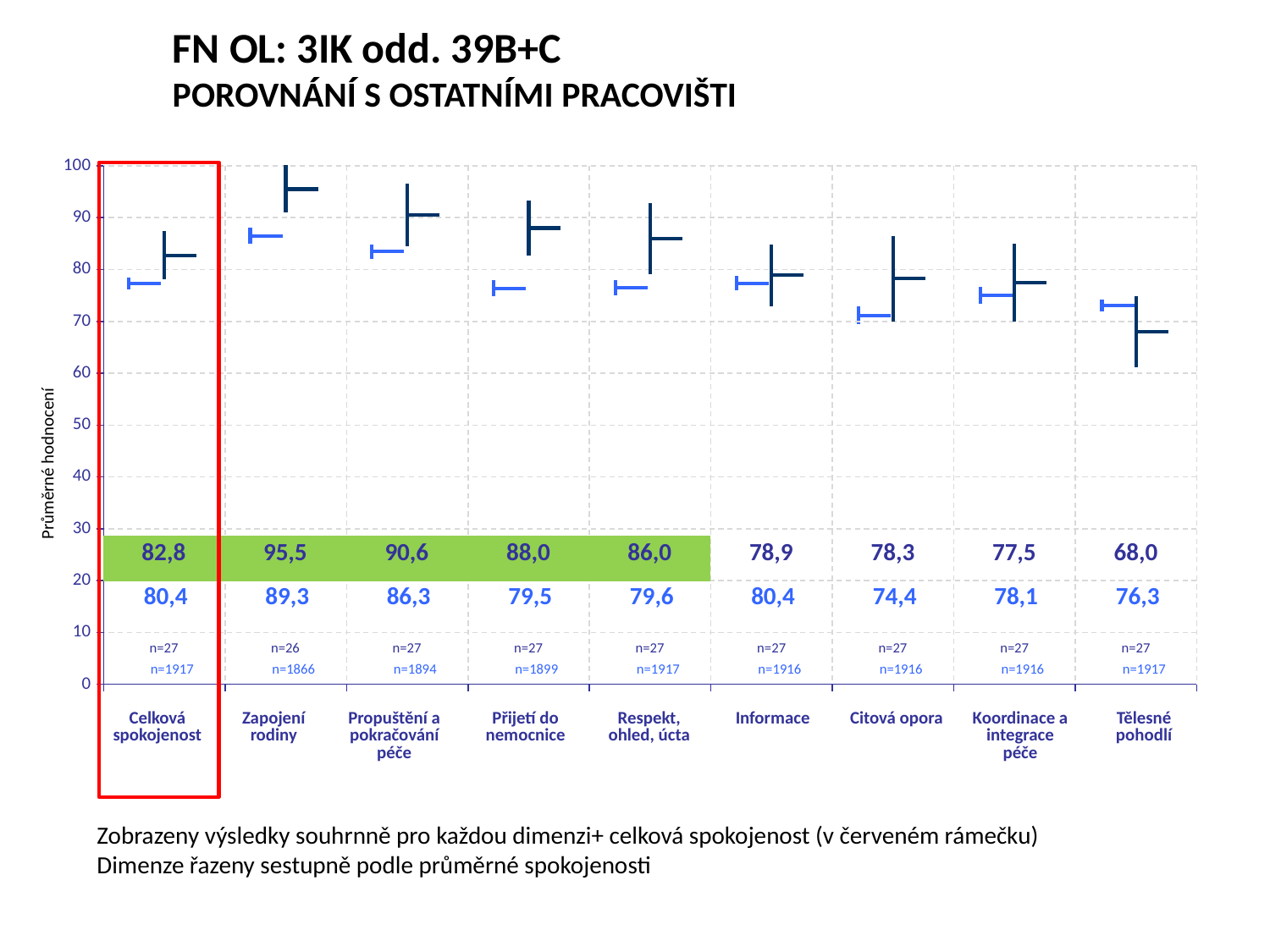
What is the light blue (bottom row) value for Citová opora? 74,4 What is the dark blue (top row) value for Zapojení rodiny? 95,5 Is the dark blue value for Tělesné pohodlí greater or less than 70? less Which category has the highest dark blue (top row) value? Zapojení rodiny For Tělesné pohodlí, which is larger: the dark blue value or the light blue value? the light blue value (76,3) What is the difference between the dark blue and light blue values for Zapojení rodiny? 6,2 Which category has the lowest dark blue (top row) value? Tělesné pohodlí How many categories are shown on the x axis? 9 Which category is highlighted with a red frame? Celková spokojenost What is the difference between the dark blue and light blue values for Celková spokojenost? 2,4 What is the light blue (bottom row) value for Přijetí do nemocnice? 79,5 Do the dark blue (top row) values rise or fall from Zapojení rodiny to Tělesné pohodlí? fall